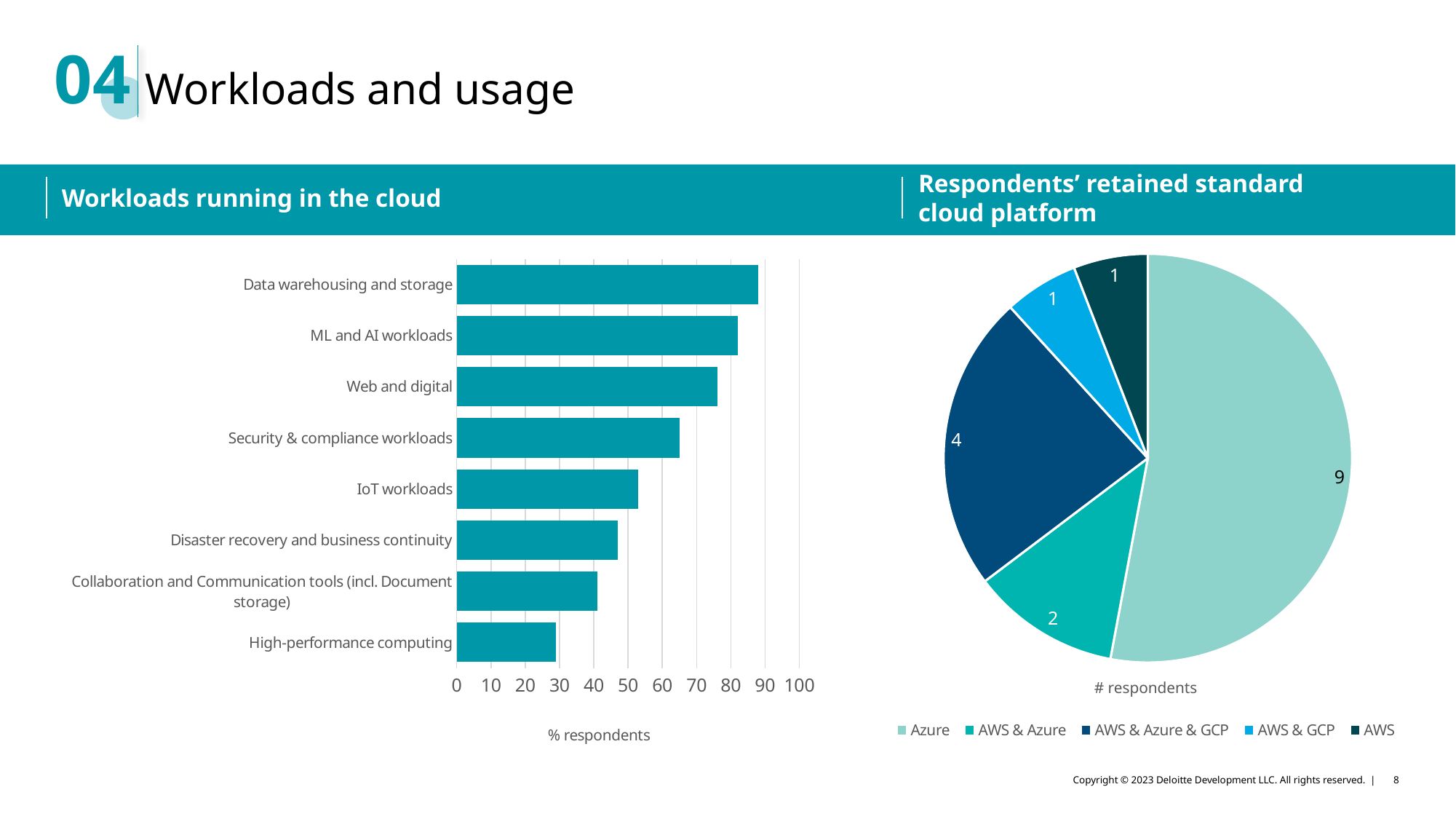
In the 'Workloads running in the cloud' chart, which is larger: ML and AI workloads or Web and digital? ML and AI workloads In the 'Workloads running in the cloud' chart, how many workload categories are shown? 8 In the 'Respondents' retained standard cloud platform' pie chart, what is the difference between the Azure and AWS & Azure & GCP slices? 5 In the 'Respondents' retained standard cloud platform' pie chart, how many respondents retained AWS & Azure & GCP? 4 In the 'Workloads running in the cloud' chart, is the value for High-performance computing greater or less than 40? less In the 'Workloads running in the cloud' chart, which workload has the highest percentage of respondents? Data warehousing and storage In the 'Workloads running in the cloud' chart, which workload has the lowest percentage of respondents? High-performance computing What kind of chart is 'Workloads running in the cloud'? bar chart In the 'Workloads running in the cloud' chart, is the value for Data warehousing and storage greater or less than 80? greater How many entries does the legend of the 'Respondents' retained standard cloud platform' pie chart list? 5 In the 'Workloads running in the cloud' chart, is the value for Security & compliance workloads greater or less than 60? greater In the 'Respondents' retained standard cloud platform' pie chart, how many respondents retained Azure? 9